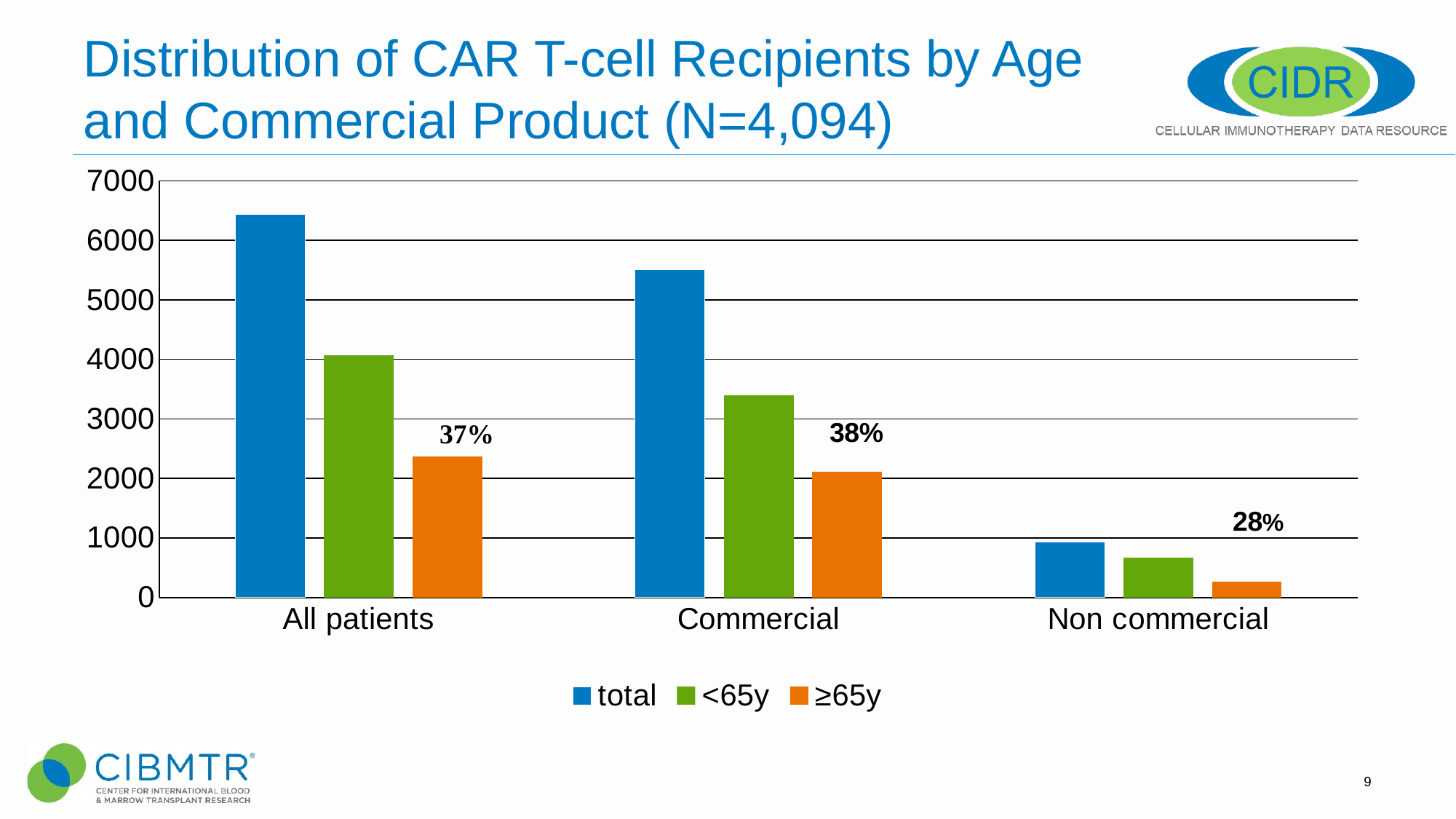
Is the total value for Non commercial greater or less than 1000? less How many categories are shown on the x axis? 3 Which category has the highest total bar? All patients What percentage label is shown above the ≥65y bar for Commercial? 38% What kind of chart is shown on the slide? bar chart Which is larger, the total for Commercial or the total for Non commercial? Commercial What percentage label is shown above the ≥65y bar for Non commercial? 28% Which category has the lowest total bar? Non commercial What are the three series listed in the legend? total, <65y, ≥65y What percentage label is shown above the ≥65y bar for All patients? 37% Is the total value for All patients greater or less than 6000? greater How many series does the legend list? 3